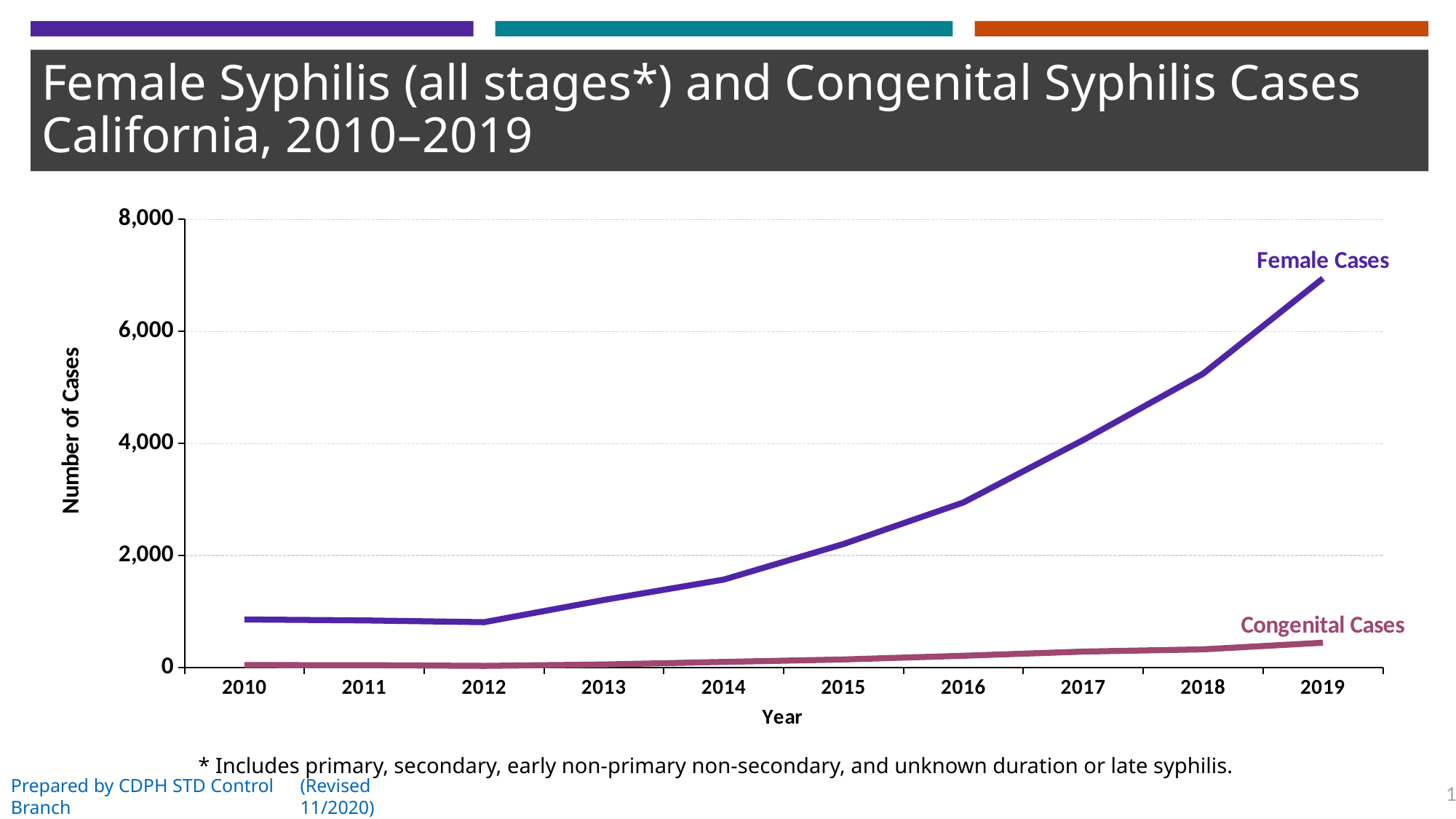
In 2019, which series has the larger value, Female Cases or Congenital Cases? Female Cases How many series are plotted on the chart? 2 Is the value for Congenital Cases in 2019 greater or less than 2,000? less Is the value for Female Cases in 2018 greater or less than 4,000? greater Do Female Cases rise or fall between 2012 and 2019? Rise What is the label on the y axis of the chart? Number of Cases Is the value for Female Cases in 2019 greater or less than 6,000? greater What kind of chart is shown on the slide? Line chart In which year is the Female Cases line at its highest? 2019 How many years are shown along the x axis of the chart? 10